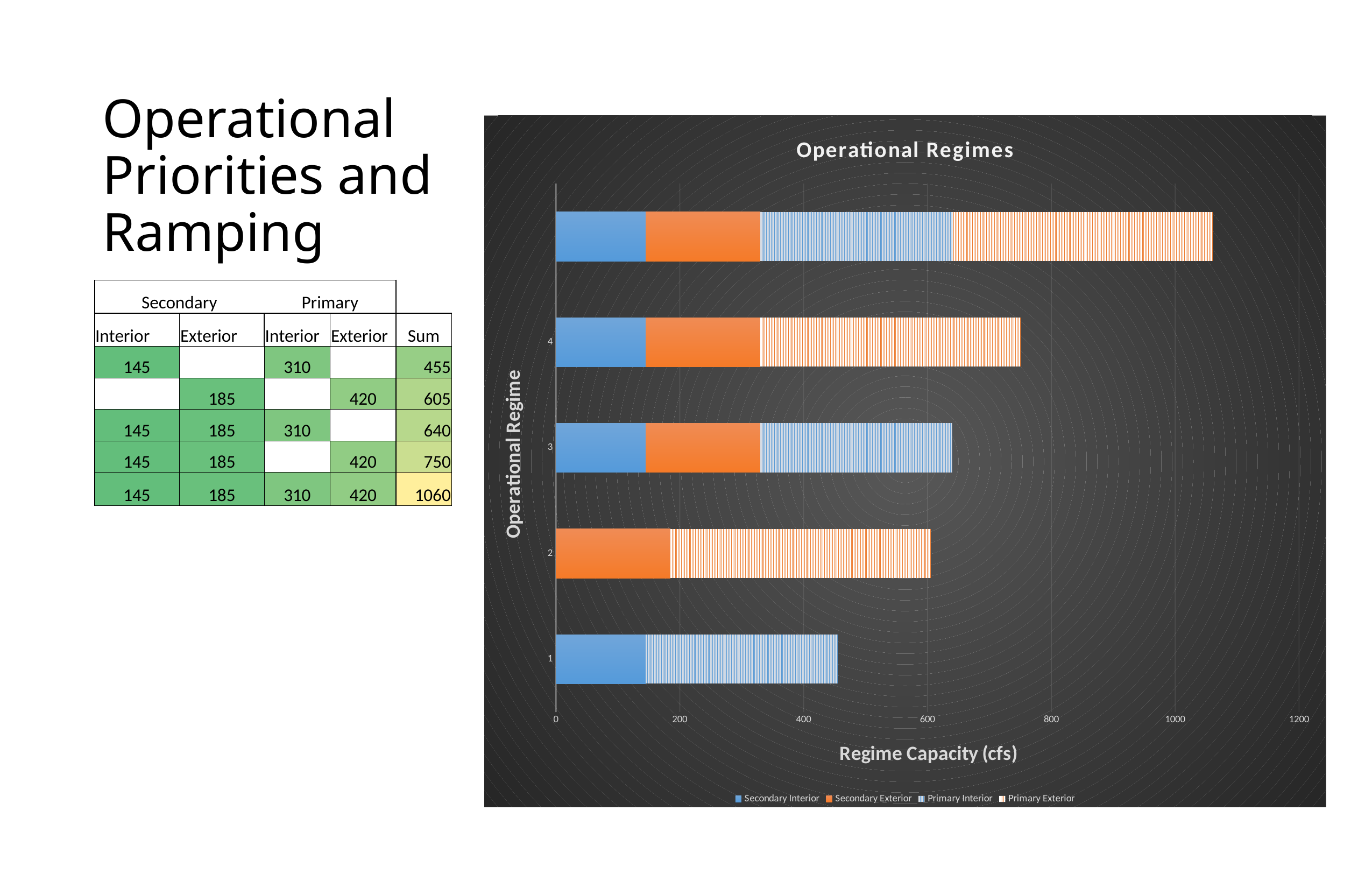
In the Operational Regimes chart, which has the larger total, regime 4 or regime 3? regime 4 What is the y-axis title of the Operational Regimes chart? Operational Regime In the Operational Regimes chart, is the total for the top bar greater or less than 1000? greater In the Operational Regimes chart, which has the larger total, regime 1 or regime 2? regime 2 In the Operational Regimes chart, is the total for regime 4 greater or less than 800? less What kind of chart is shown on the slide? bar chart What is the x-axis title of the Operational Regimes chart? Regime Capacity (cfs) In the Operational Regimes chart, which of the labelled regimes 1 to 4 has the shortest bar? regime 1 How many bars are plotted in the Operational Regimes chart? 5 In the Operational Regimes chart, is the total for regime 1 greater or less than 400? greater How many series does the legend of the Operational Regimes chart list? 4